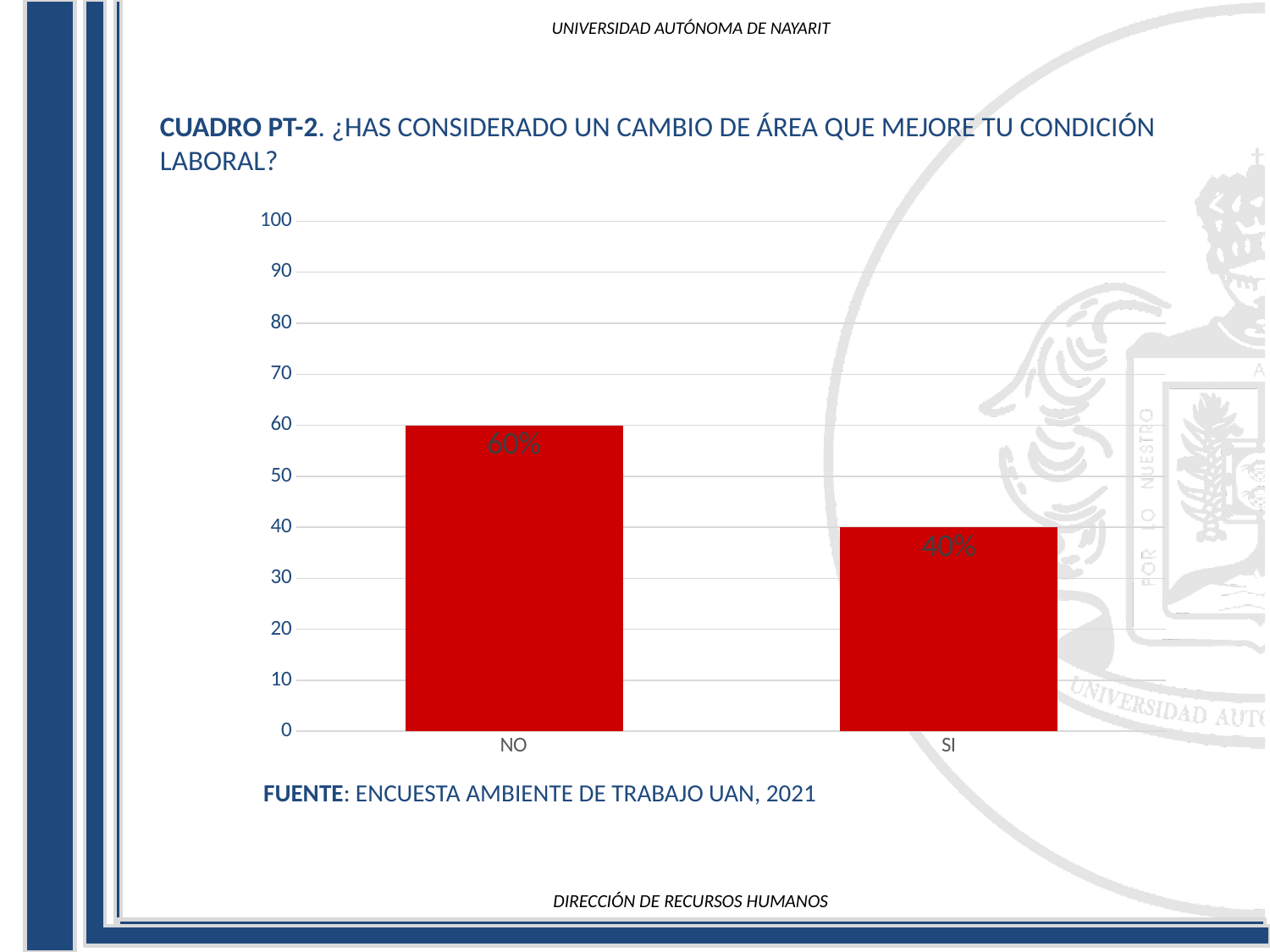
What is the maximum value shown on the y axis? 100 What is the difference between the values for NO and SI? 20% Which category has the highest value? NO What is the value for NO? 60% What kind of chart is shown on the slide? bar chart What colour are the bars in the chart? red Which is larger, the value for NO or the value for SI? NO What is the value for SI? 40% Which category has the lowest value? SI Is the value for NO greater or less than 50? greater How many categories are shown on the x axis? 2 Is the value for SI greater or less than 50? less